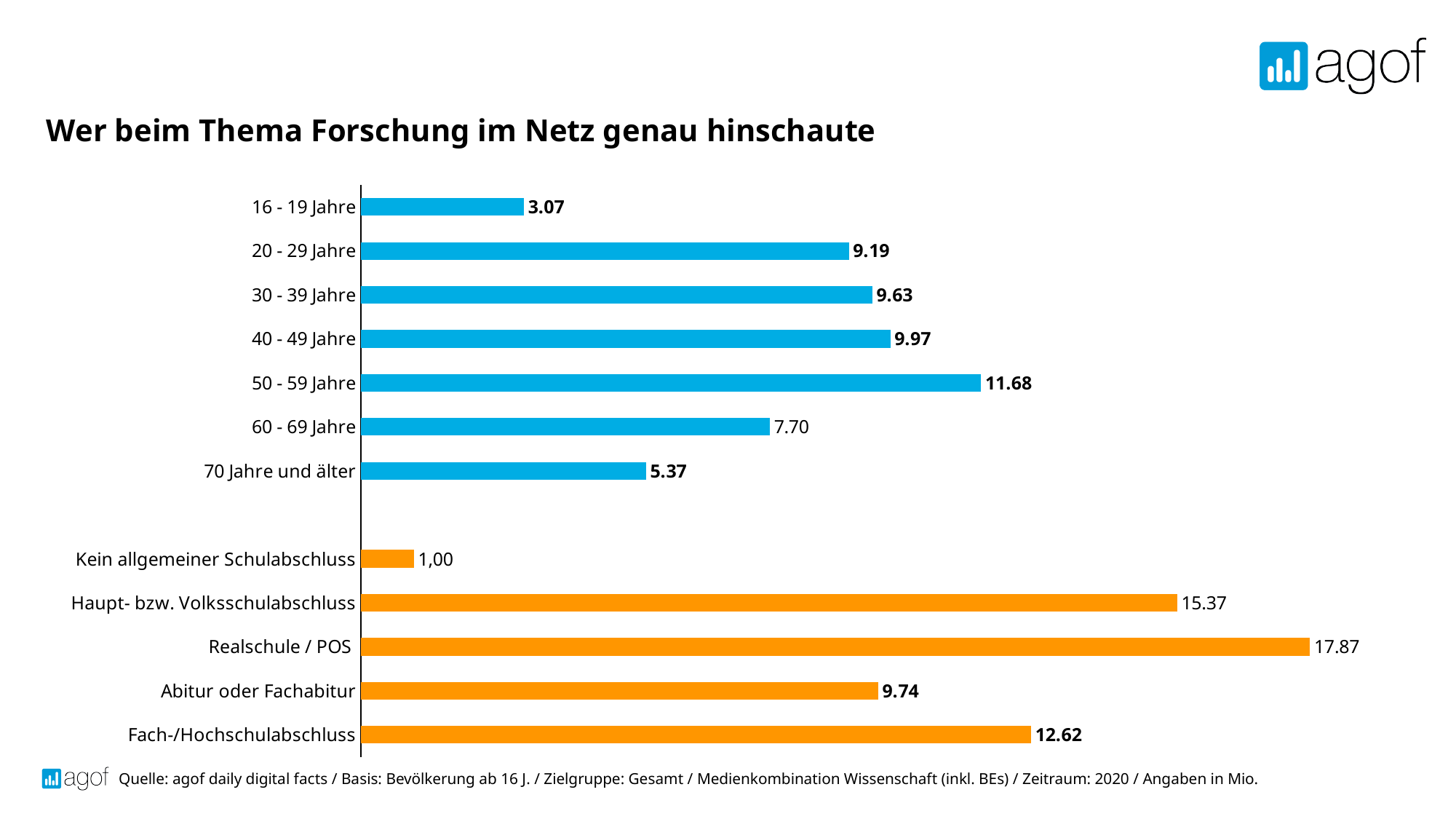
What is the value for the 50 - 59 Jahre age group? 11.68 How many categories are plotted in the chart? 12 What is the value for Realschule / POS? 17.87 Which has the larger value, Fach-/Hochschulabschluss or Abitur oder Fachabitur? Fach-/Hochschulabschluss Which category has the lowest value in the chart? Kein allgemeiner Schulabschluss What kind of chart is shown on the slide? bar chart What is the value for 70 Jahre und älter? 5.37 Among the age groups, which one has the highest value? 50 - 59 Jahre Which category has the highest value in the chart? Realschule / POS What is the difference between the values for Realschule / POS and Haupt- bzw. Volksschulabschluss? 2.50 What is the value for Kein allgemeiner Schulabschluss? 1,00 What is the difference between the values for 50 - 59 Jahre and 40 - 49 Jahre? 1.71